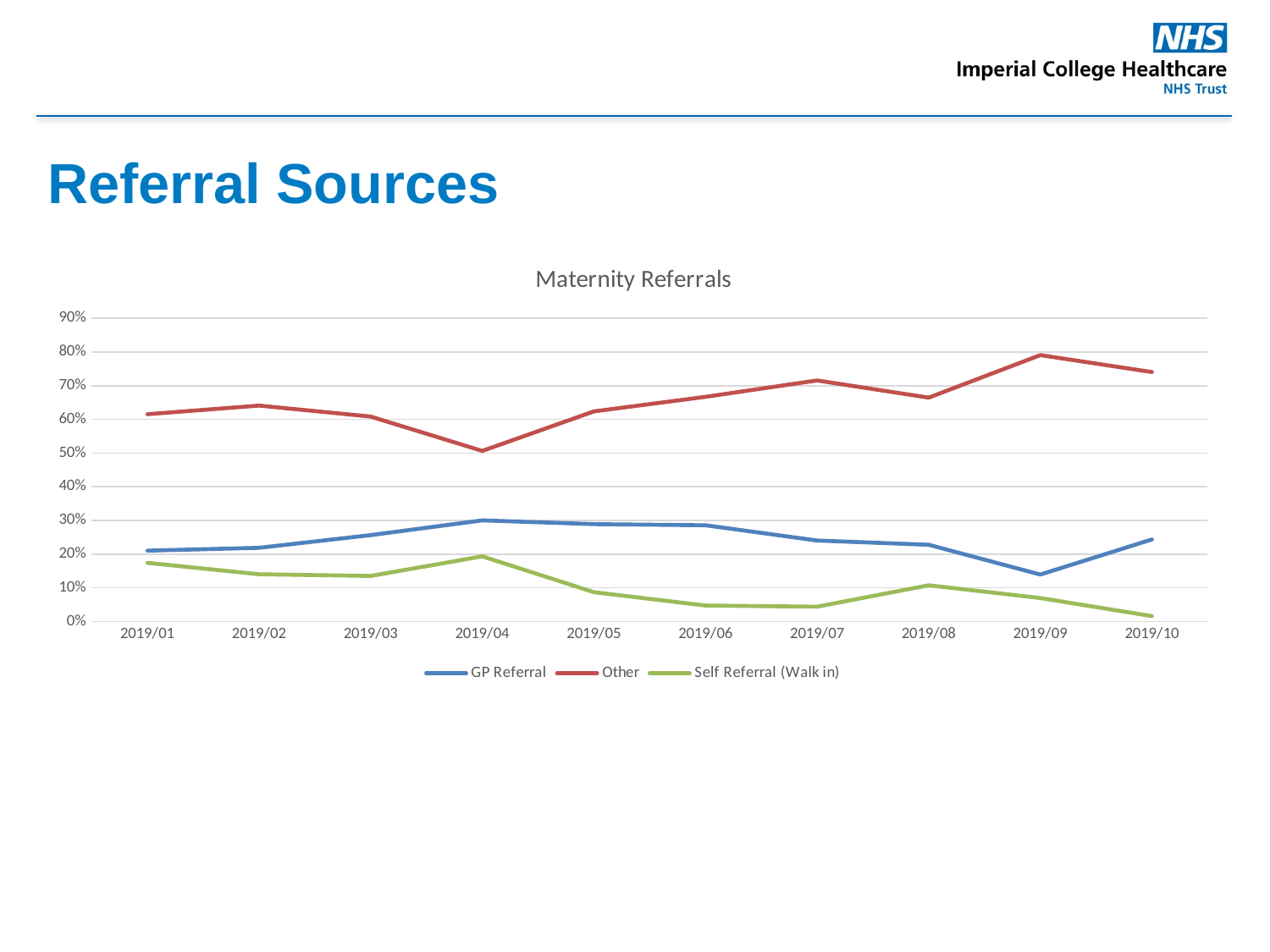
What kind of chart is shown on the slide? line chart In which month is the GP Referral series at its lowest? 2019/09 In which month is the Self Referral (Walk in) series at its lowest? 2019/10 Which is larger in 2019/01, the Other value or the GP Referral value? Other What is the title of the chart? Maternity Referrals How many series does the legend list? 3 Is the value for Other in 2019/09 greater or less than 70%? greater Is the value for GP Referral in 2019/09 greater or less than 20%? less In which month does the Other series reach its highest value? 2019/09 In which month does the Other series reach its lowest value? 2019/04 How many months are plotted along the x axis? 10 Does the Self Referral (Walk in) series rise or fall from 2019/08 to 2019/10? fall